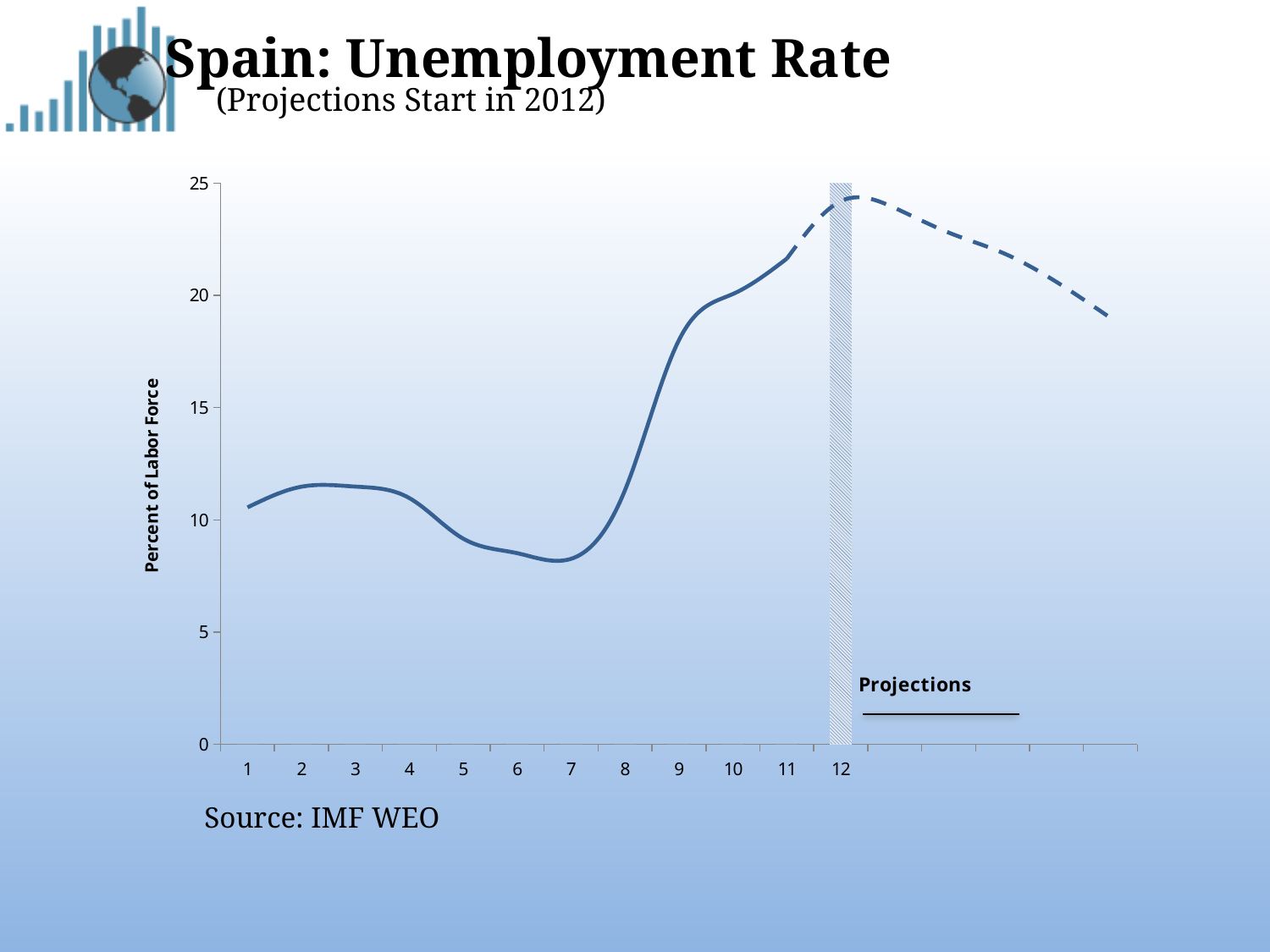
Among the labeled x-axis points 1 to 12, at which point is the unemployment rate lowest? 7 Among the labeled x-axis points 1 to 12, at which point is the unemployment rate highest? 12 Is the value at x = 7 greater or less than 10? less Does the unemployment rate rise or fall between x = 7 and x = 12? rise Is the value at x = 12 greater or less than 20? greater What kind of chart is shown on the slide? line chart Is the value at x = 11 greater or less than 20? greater Which is larger, the value at x = 9 or the value at x = 3? x = 9 What source is cited below the chart? IMF WEO What is the y-axis title of the chart? Percent of Labor Force